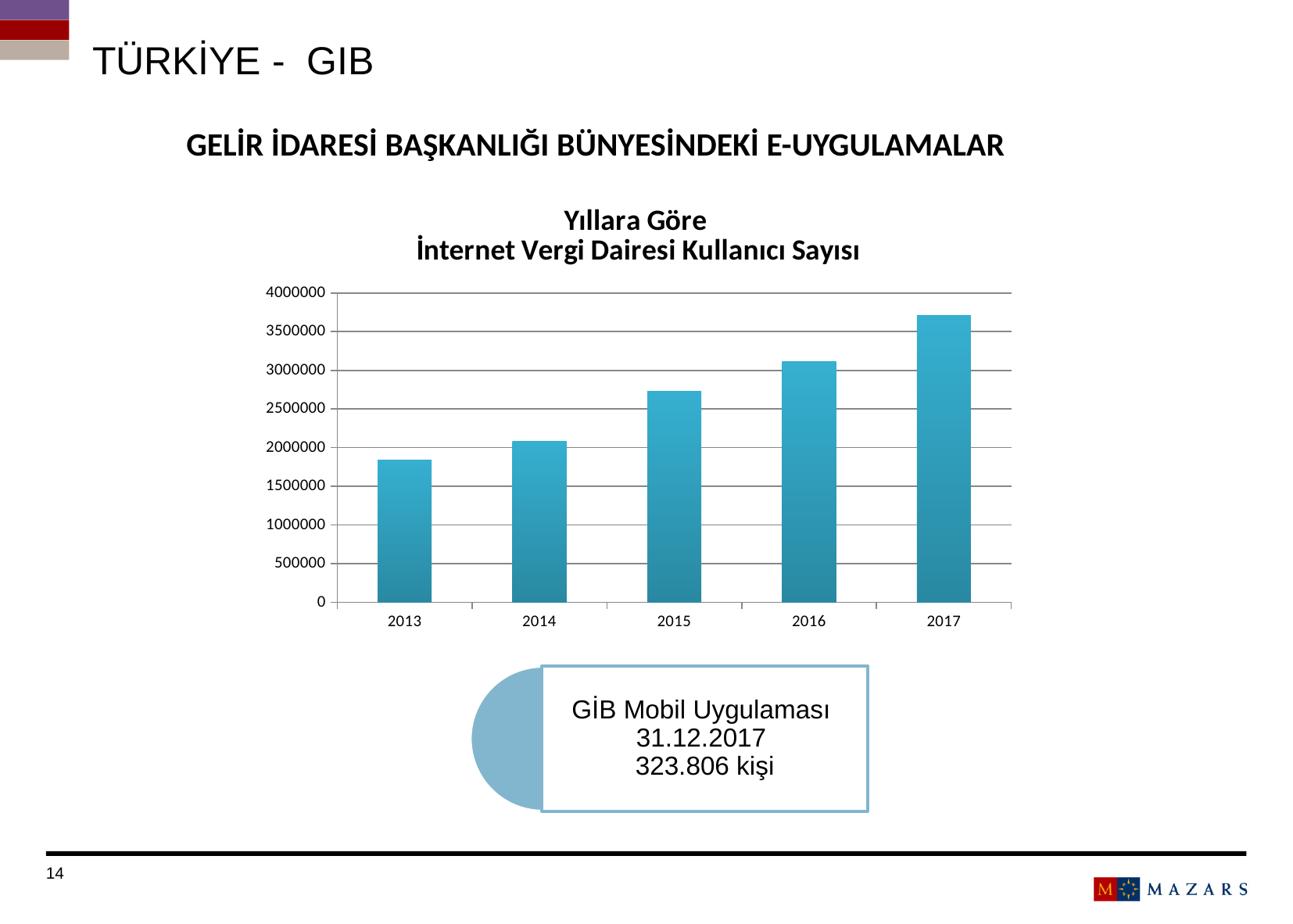
Which year has the highest number of users in the chart? 2017 Which year has the lowest number of users in the chart? 2013 What is the title of the chart? Yıllara Göre İnternet Vergi Dairesi Kullanıcı Sayısı Do the values rise or fall from 2013 to 2017 in the chart? rise How many years are shown on the x axis of the chart? 5 Is the value for 2017 greater or less than 3500000? greater What kind of chart is shown on the slide? bar chart What is the highest value shown on the y axis of the chart? 4000000 Is the value for 2015 greater or less than 2500000? greater Which is larger, the value for 2014 or the value for 2016? 2016 Is the value for 2013 greater or less than 2000000? less